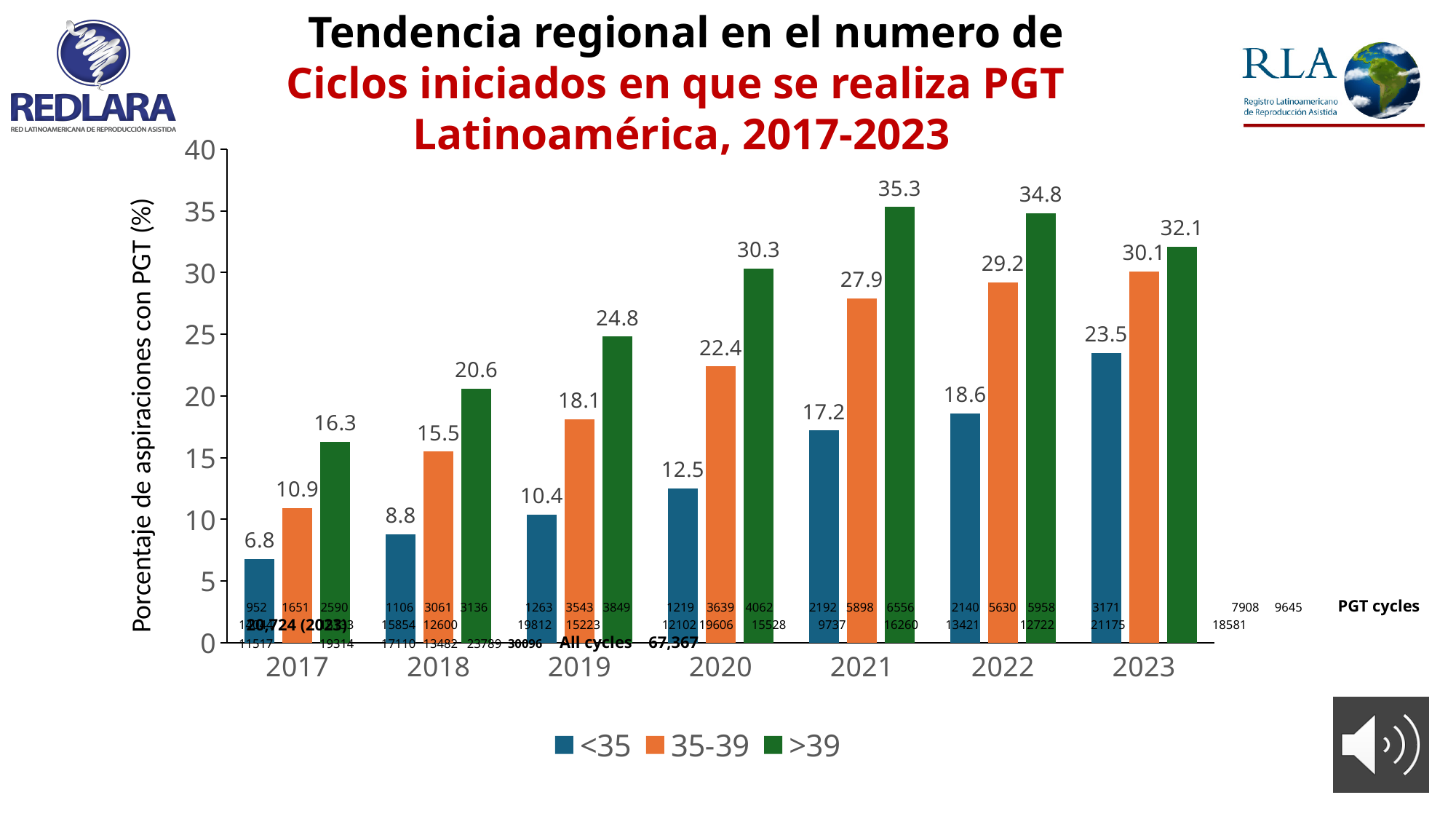
What kind of chart is shown on the slide? bar chart Does the <35 series rise or fall from 2017 to 2023? rise Is the value for the 35-39 series in 2022 greater or less than 25? greater What is the value for the <35 series in 2017? 6.8 What is the value for the >39 series in 2021? 35.3 What is the difference between the >39 and <35 values in 2023? 8.6 In which year is the <35 series lowest? 2017 How many series does the legend list? 3 What is the value for the 35-39 series in 2020? 22.4 Which is larger in 2019: the 35-39 value or the >39 value? >39 In which year is the >39 series highest? 2021 How many years are shown on the x axis? 7